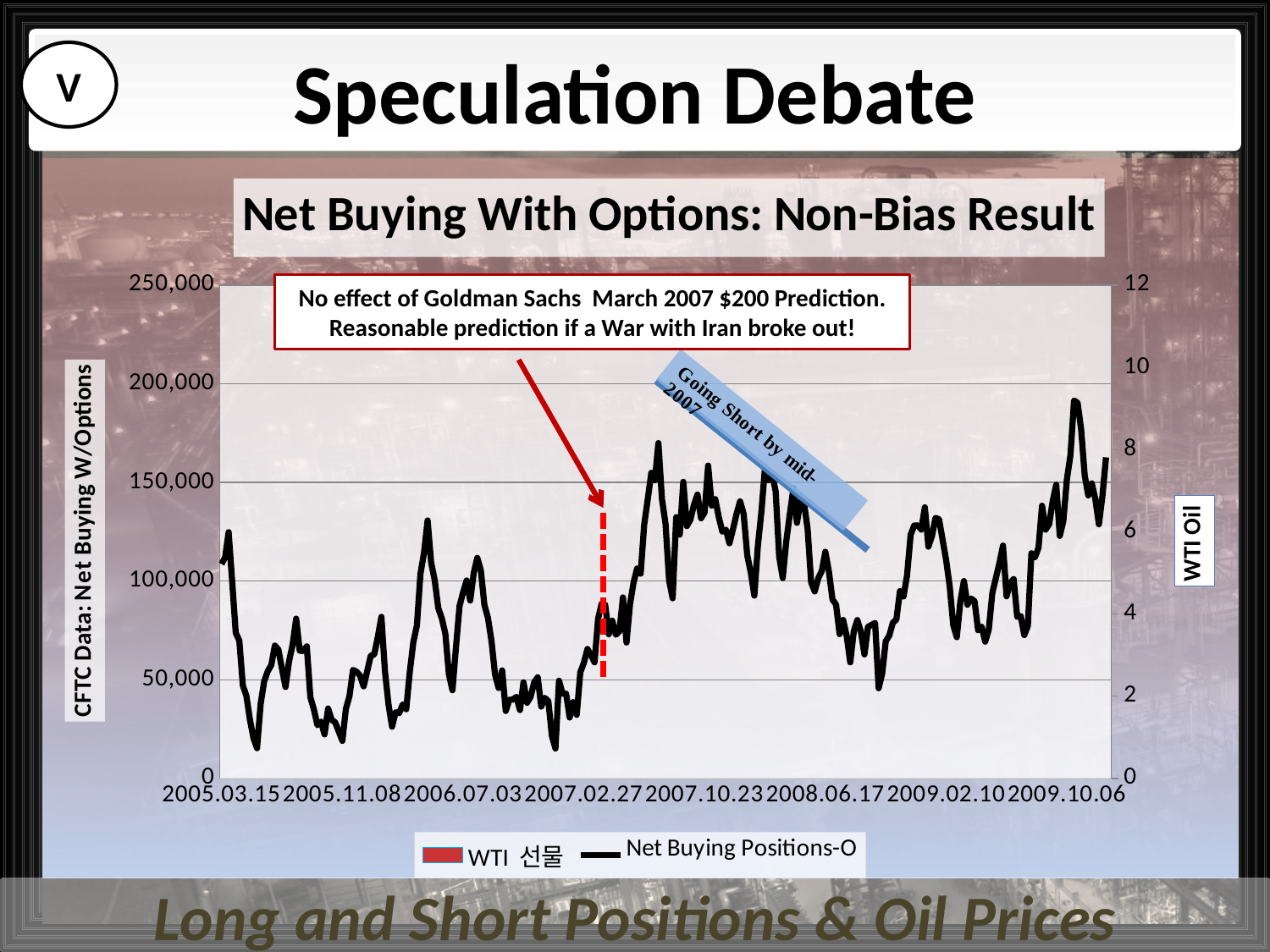
What is the title of the chart? Net Buying With Options: Non-Bias Result Is the highest value of the Net Buying Positions-O line greater or less than 150,000? greater Which is larger for Net Buying Positions-O: the value at 2007.10.23 or the value at 2007.02.27? 2007.10.23 Is the Net Buying Positions-O value at 2007.02.27 greater or less than 50,000? greater Near which x-axis date label does the Net Buying Positions-O line reach its highest peak? 2009.10.06 How many series does the chart legend list? 2 Is the Net Buying Positions-O value at 2007.02.27 greater or less than 100,000? less What kind of chart is shown on the slide? line chart How many date labels are shown along the x axis? 8 What is the label of the left vertical axis? CFTC Data: Net Buying W/Options